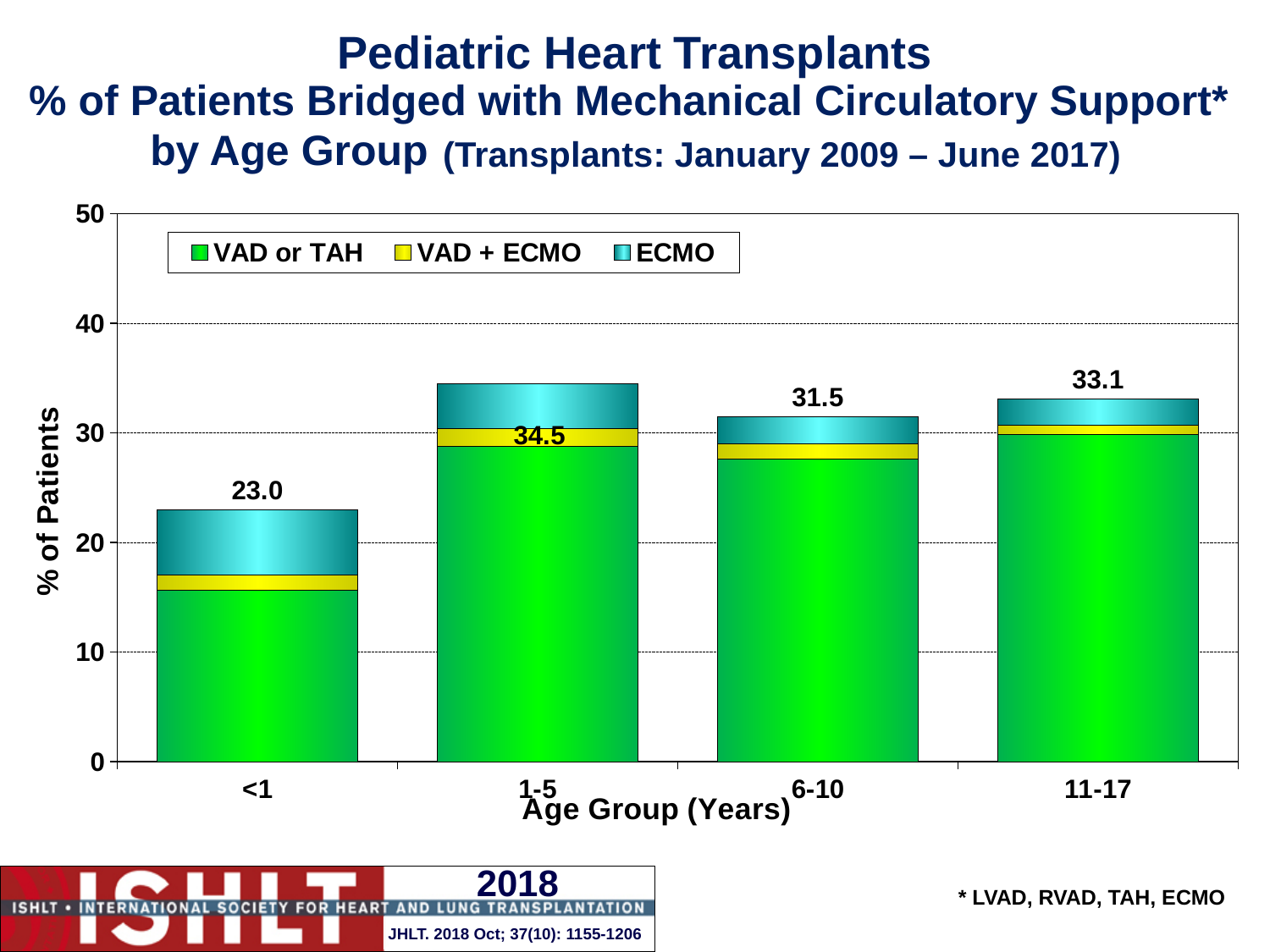
How many age groups are shown on the x axis? 4 Which age group has a larger total percentage, 6-10 or 11-17? 11-17 Which age group has the highest total percentage of patients bridged with mechanical circulatory support? 1-5 What is the total percentage shown for the 1-5 age group? 34.5 Is the VAD or TAH value for the 11-17 age group greater or less than 20? greater What is the total percentage shown for the 6-10 age group? 31.5 What kind of chart is shown on the slide? Stacked bar chart What is the difference between the total percentage for the 1-5 age group and the <1 age group? 11.5 How many series does the legend list? 3 What is the total percentage of patients bridged with mechanical circulatory support in the <1 age group? 23.0 Which age group has the lowest total percentage of patients bridged with mechanical circulatory support? <1 What is the total percentage shown for the 11-17 age group? 33.1